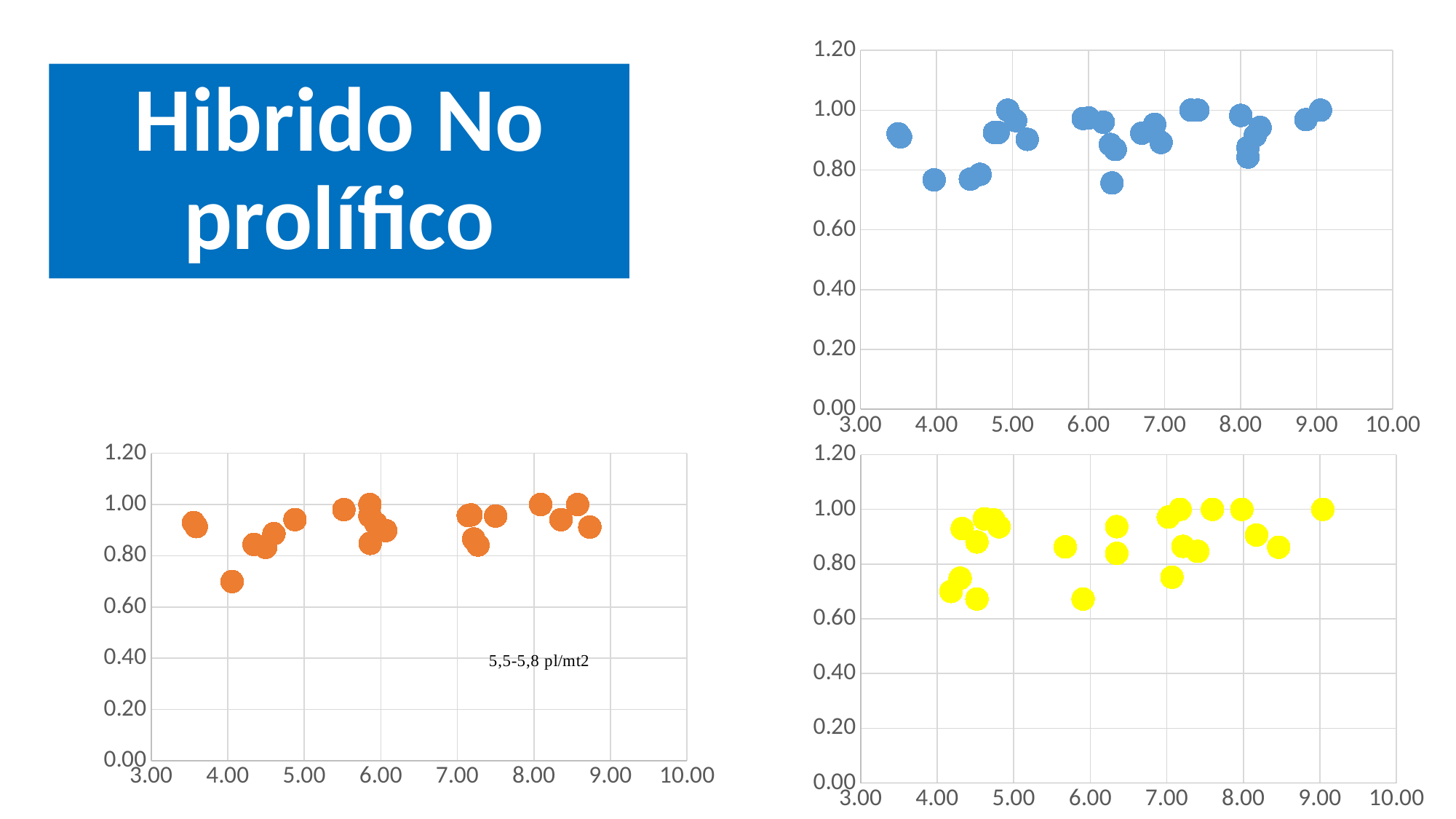
In the bottom-left chart, is the lowest orange point (near x = 4.00) greater or less than 0.80 on the y axis? less What is the maximum value shown on the y axis of the top-right chart? 1.20 How many charts are shown on the slide? 3 What text annotation appears inside the bottom-left chart? 5,5-5,8 pl/mt2 In the top-right chart, is the lowest blue point (near x = 6.30) greater or less than 0.60 on the y axis? greater What kind of chart is the top-right chart with blue markers? scatter chart In the top-right chart, is the lowest blue point (near x = 6.30) greater or less than 0.80 on the y axis? less What kind of chart is the bottom-left chart with orange markers? scatter chart